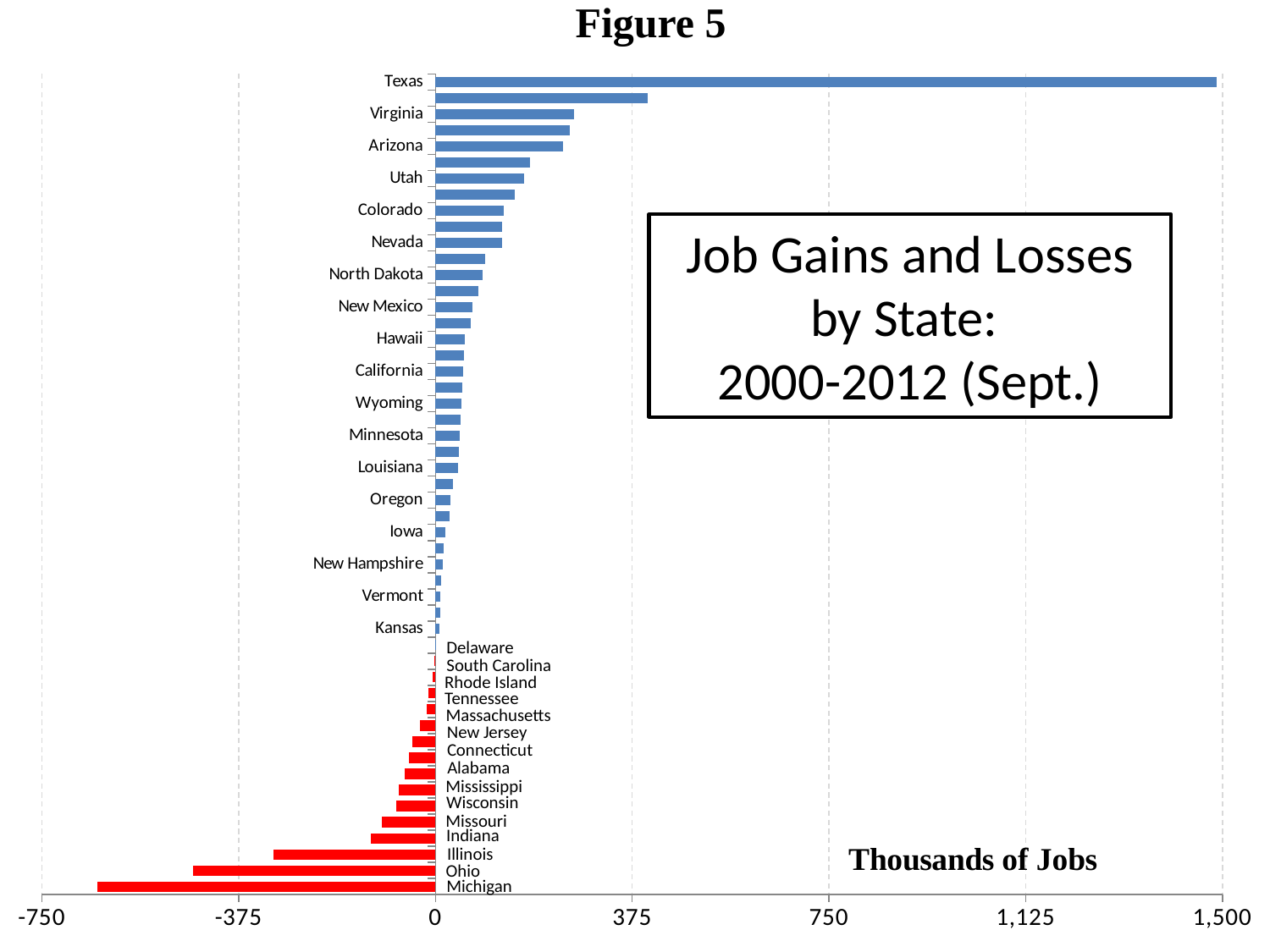
What kind of chart is shown on the slide? bar chart What unit label is shown for the horizontal axis? Thousands of Jobs Which has the larger value, Texas or Virginia? Texas Is the value for Michigan greater or less than -375? less Is the value for Virginia greater or less than 375? less Which state has the highest value in the chart? Texas Which has the larger value, Illinois or Ohio? Illinois Is the value for Ohio greater or less than -375? less What is the title shown in the box on the chart? Job Gains and Losses by State: 2000-2012 (Sept.) Which state has the lowest value in the chart? Michigan